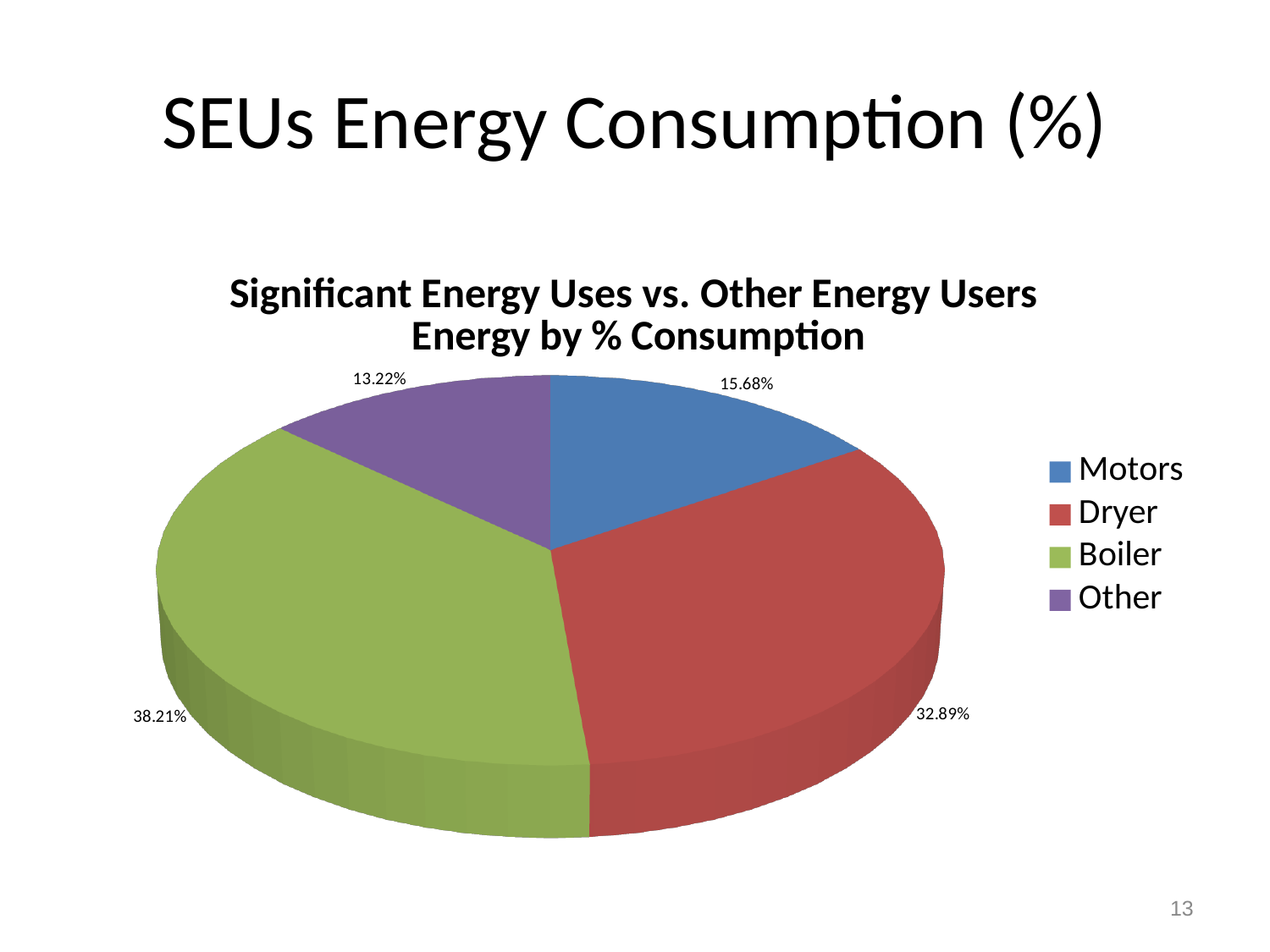
What percentage of energy consumption is attributed to Other? 13.22% Which has a larger share, Dryer or Motors? Dryer Which category has the smallest share of energy consumption? Other How many categories are shown in the pie chart? 4 What percentage of energy consumption is attributed to Boiler? 38.21% What type of chart is shown on the slide? Pie chart What is the difference in percentage points between Boiler and Dryer? 5.32 What percentage of energy consumption is attributed to Motors? 15.68% Which category has the largest share of energy consumption? Boiler What is the difference in percentage points between Motors and Other? 2.46 What is the title of the chart? Significant Energy Uses vs. Other Energy Users Energy by % Consumption What percentage of energy consumption is attributed to Dryer? 32.89%